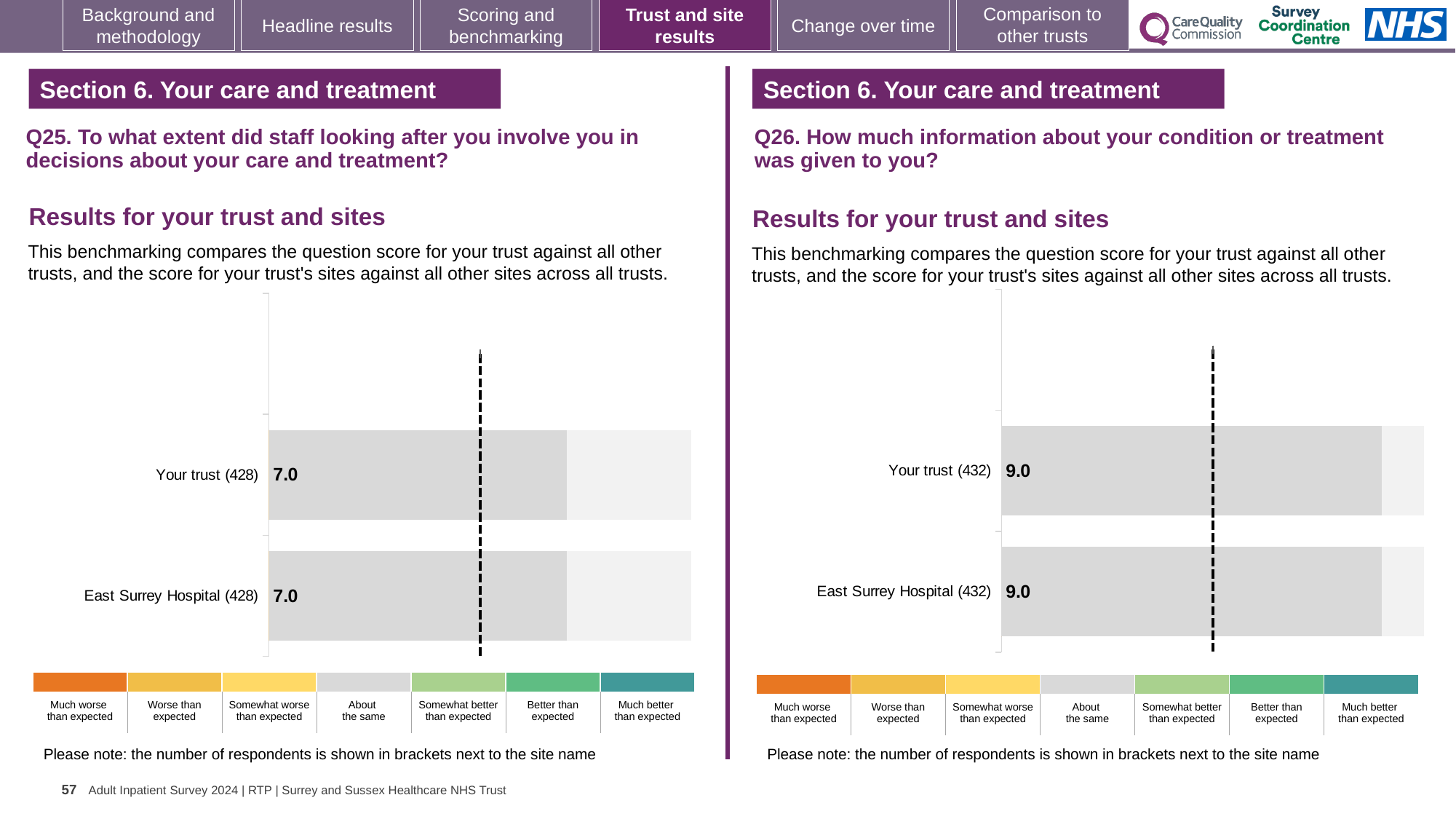
On the Q26 chart (right), how many bars are plotted? 2 On the Q25 chart (left), what is the score for Your trust? 7.0 How many categories does the colour key below the Q26 chart (right) list? 7 On the Q25 chart (left), what is the label of the bottom bar? East Surrey Hospital (428) On the Q25 chart (left), what is the difference between the score for Your trust and the score for East Surrey Hospital? 0.0 On the Q26 chart (right), how many respondents are shown in brackets next to East Surrey Hospital? 432 On the Q25 chart (left), what is the score for East Surrey Hospital? 7.0 On the Q26 chart (right), what is the score for East Surrey Hospital? 9.0 What kind of chart is the Q25 chart (left)? Bar chart On the Q26 chart (right), what is the score for Your trust? 9.0 Is the score for Your trust on the Q26 chart (right) larger than the score for Your trust on the Q25 chart (left)? Yes On the Q25 chart (left), how many respondents are shown in brackets next to Your trust? 428